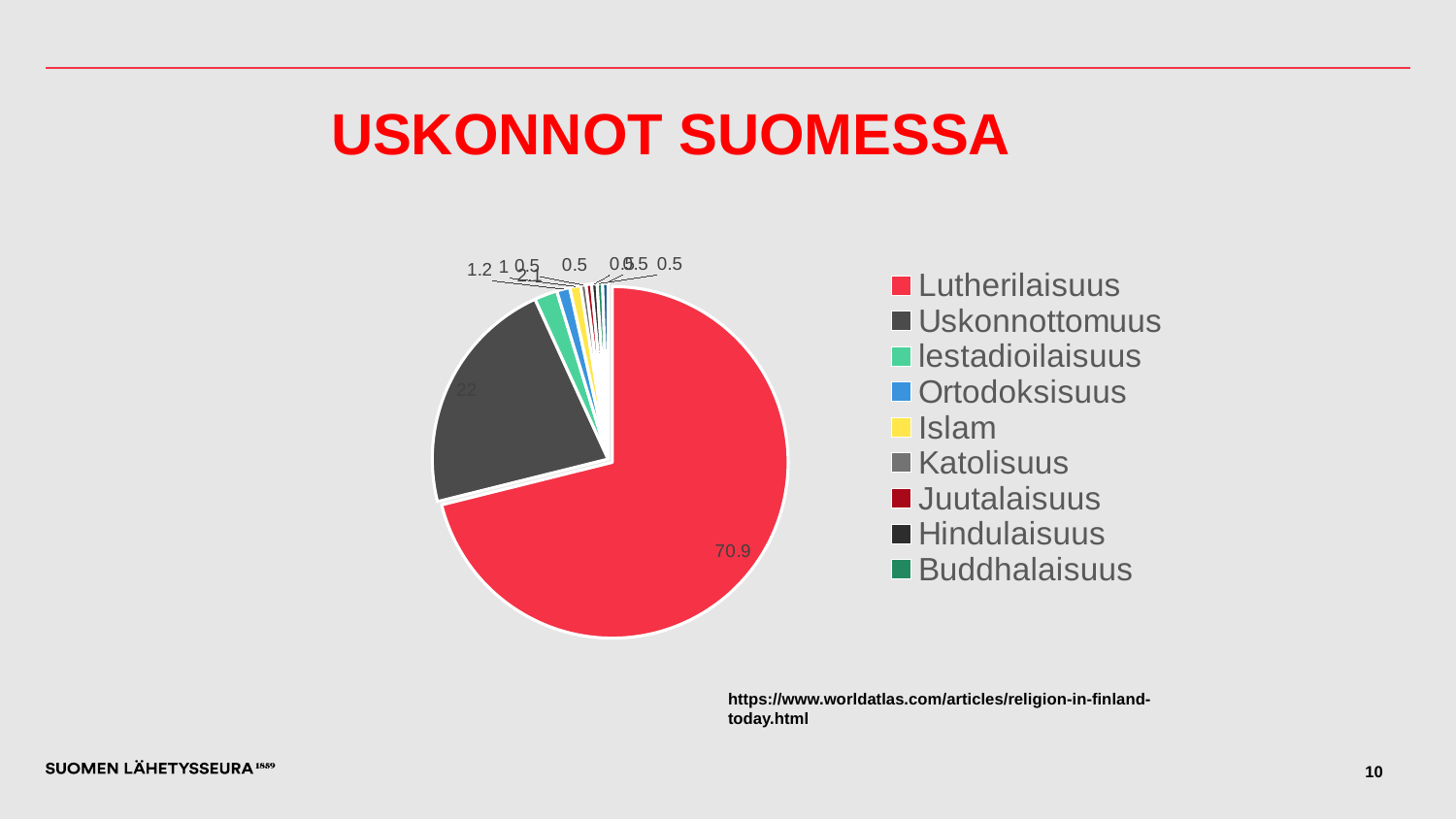
Which is larger in the pie chart, Lutherilaisuus or Uskonnottomuus? Lutherilaisuus Which is larger in the pie chart, Uskonnottomuus or lestadioilaisuus? Uskonnottomuus What value is shown for Uskonnottomuus in the pie chart? 22 What is the title of the slide containing the pie chart? USKONNOT SUOMESSA How many categories does the legend of the pie chart list? 9 What is the difference between the values for Lutherilaisuus and Uskonnottomuus? 48.9 Which colour represents Lutherilaisuus in the pie chart? red What type of chart is shown on the slide? pie chart Which category has the largest slice in the pie chart? Lutherilaisuus What value is shown for Lutherilaisuus in the pie chart? 70.9 Which category is listed second in the legend of the pie chart? Uskonnottomuus